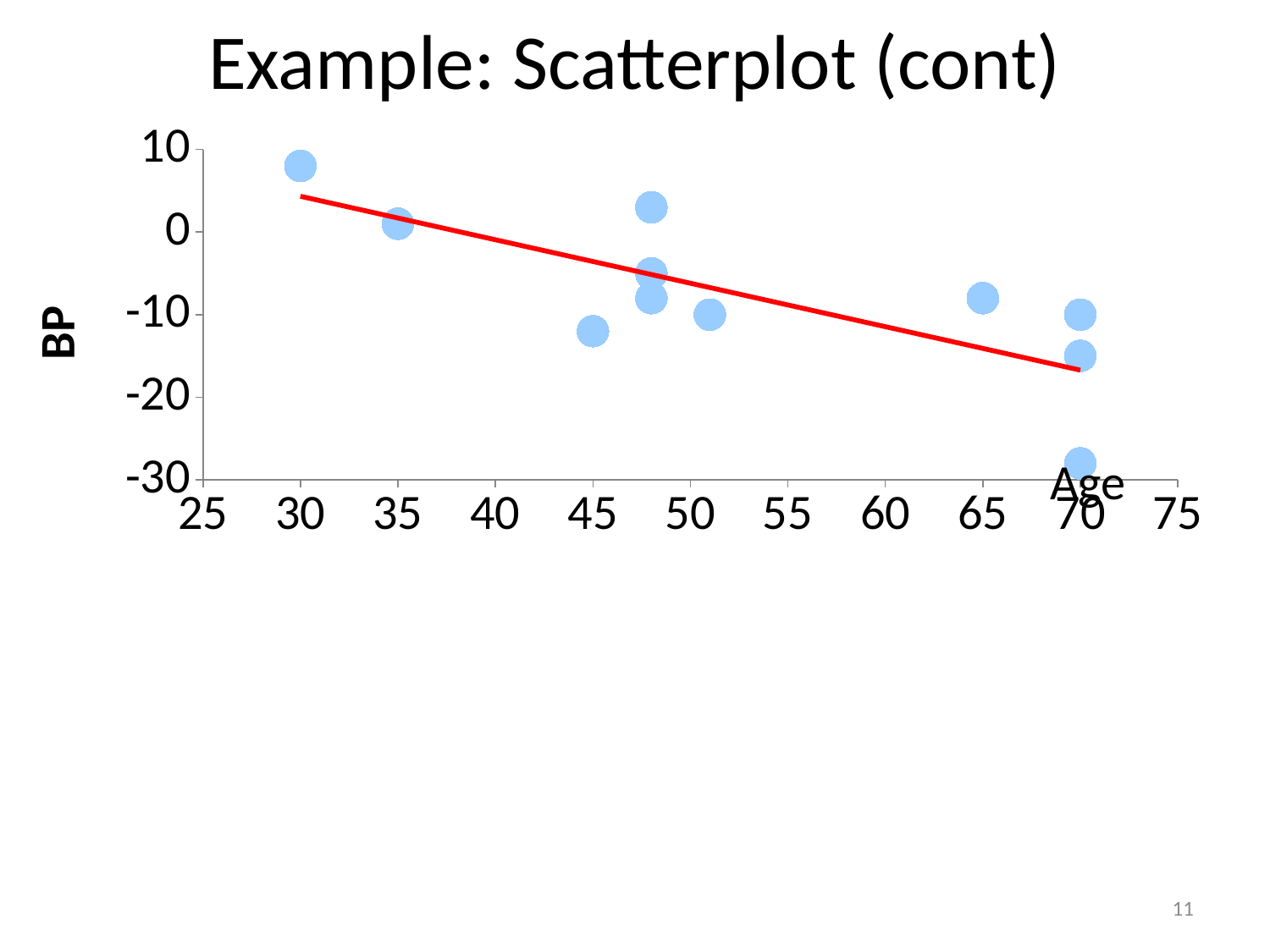
Is the BP value for the point at age 45 greater or less than -10? less Is the BP value for the point at age 35 greater or less than -10? greater Which has the larger BP value: the point at age 30 or the point at age 45? age 30 At which age does the point with the lowest BP value occur? 70 Do the BP values generally rise or fall as Age increases along the x axis? fall What kind of chart is shown on the slide? scatter plot What is the title of the chart on the slide? Example: Scatterplot (cont) Is the BP value for the lowest point at age 70 greater or less than -20? less What is the label of the vertical axis? BP At which age does the point with the highest BP value occur? 30